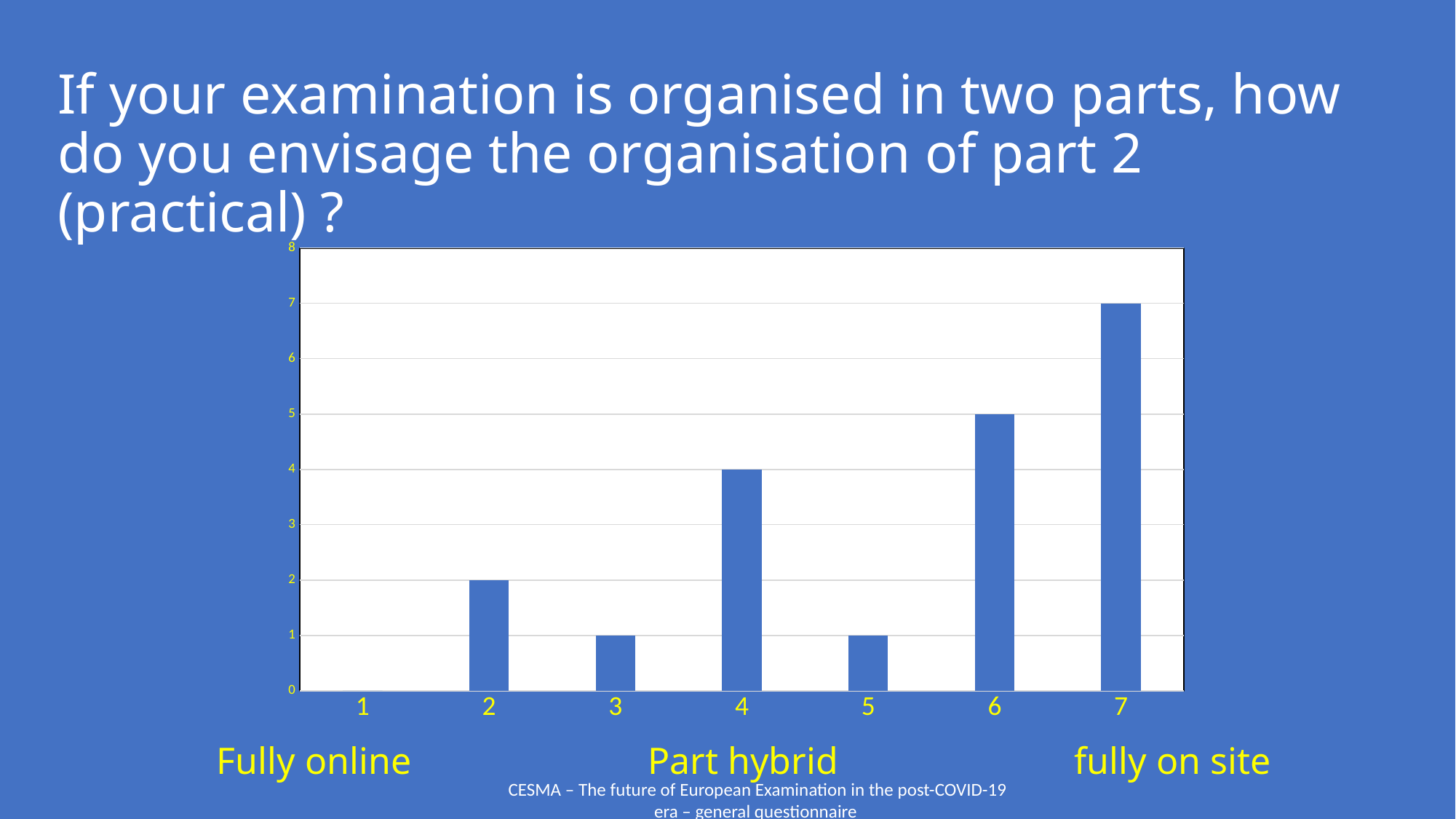
What is the value for category 6 in the chart? 5 Is the value for category 7 greater or less than 6? greater What is the difference between the values for category 7 and category 6? 2 What label is shown under the right end of the x axis? fully on site How many categories are shown on the x axis of the chart? 7 What label is shown under the left end of the x axis? Fully online Which category has the highest value in the chart? 7 Which is larger, the value for category 4 or the value for category 6? category 6 What kind of chart is shown on the slide? bar chart What is the value for category 4 in the chart? 4 What is the value for category 2 in the chart? 2 What is the value for category 7 in the chart? 7